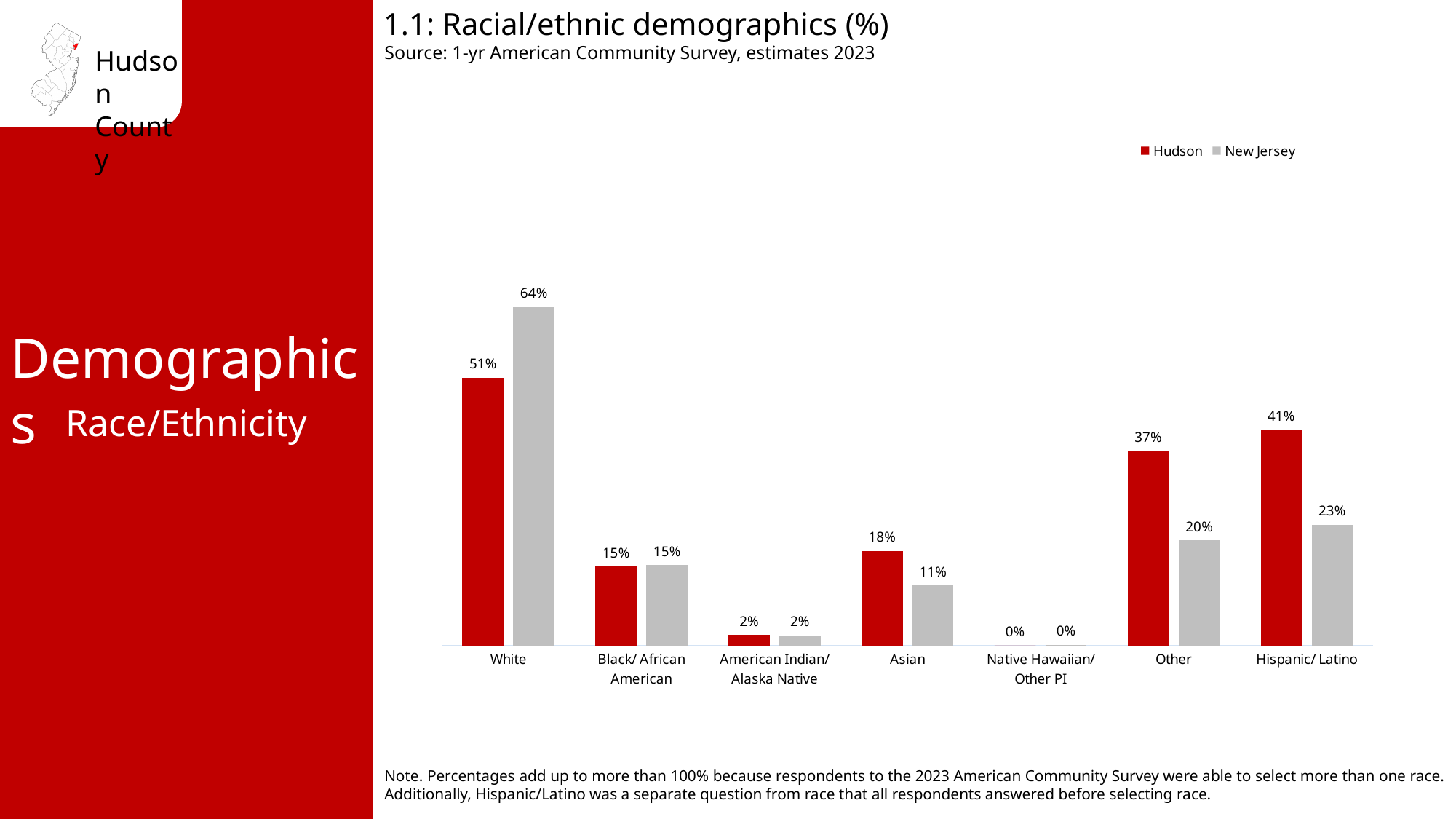
What kind of chart is shown on the slide? Bar chart What is the difference between the New Jersey and Hudson values for White? 13% Which category has the highest New Jersey value? White How many series does the legend list? 2 How many categories are shown on the x axis? 7 Which category has the lowest Hudson value? Native Hawaiian/ Other PI What is the Hudson value for White? 51% What is the Hudson value for Other? 37% What is the New Jersey value for Hispanic/ Latino? 23% Which is larger for Asian, the Hudson value or the New Jersey value? Hudson What is the New Jersey value for Asian? 11% What is the difference between the Hudson and New Jersey values for Hispanic/ Latino? 18%